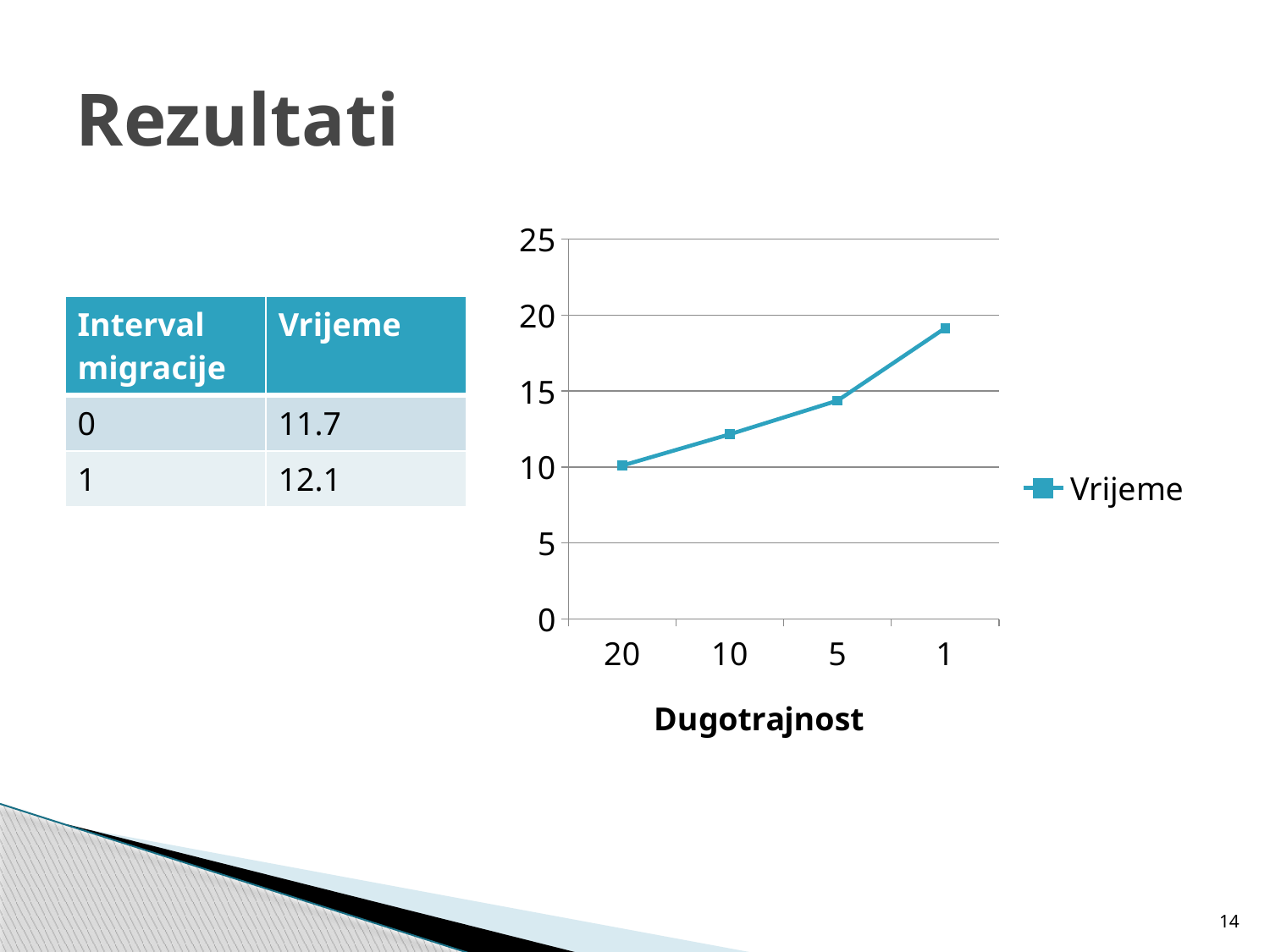
Which Dugotrajnost category has the lowest Vrijeme value on the chart? 20 Which Dugotrajnost category has the highest Vrijeme value on the chart? 1 What kind of chart is shown on the slide? line chart Is the Vrijeme value for Dugotrajnost 1 greater or less than 20? less What is the title of the x axis of the chart? Dugotrajnost Is the Vrijeme value for Dugotrajnost 20 greater or less than 15? less How many series does the legend of the chart list? 1 How many data points are plotted on the line chart? 4 Which has a larger Vrijeme value on the chart, Dugotrajnost 1 or Dugotrajnost 20? 1 Is the Vrijeme value for Dugotrajnost 5 greater or less than 15? less Do the Vrijeme values rise or fall moving left to right along the x axis of the chart? rise